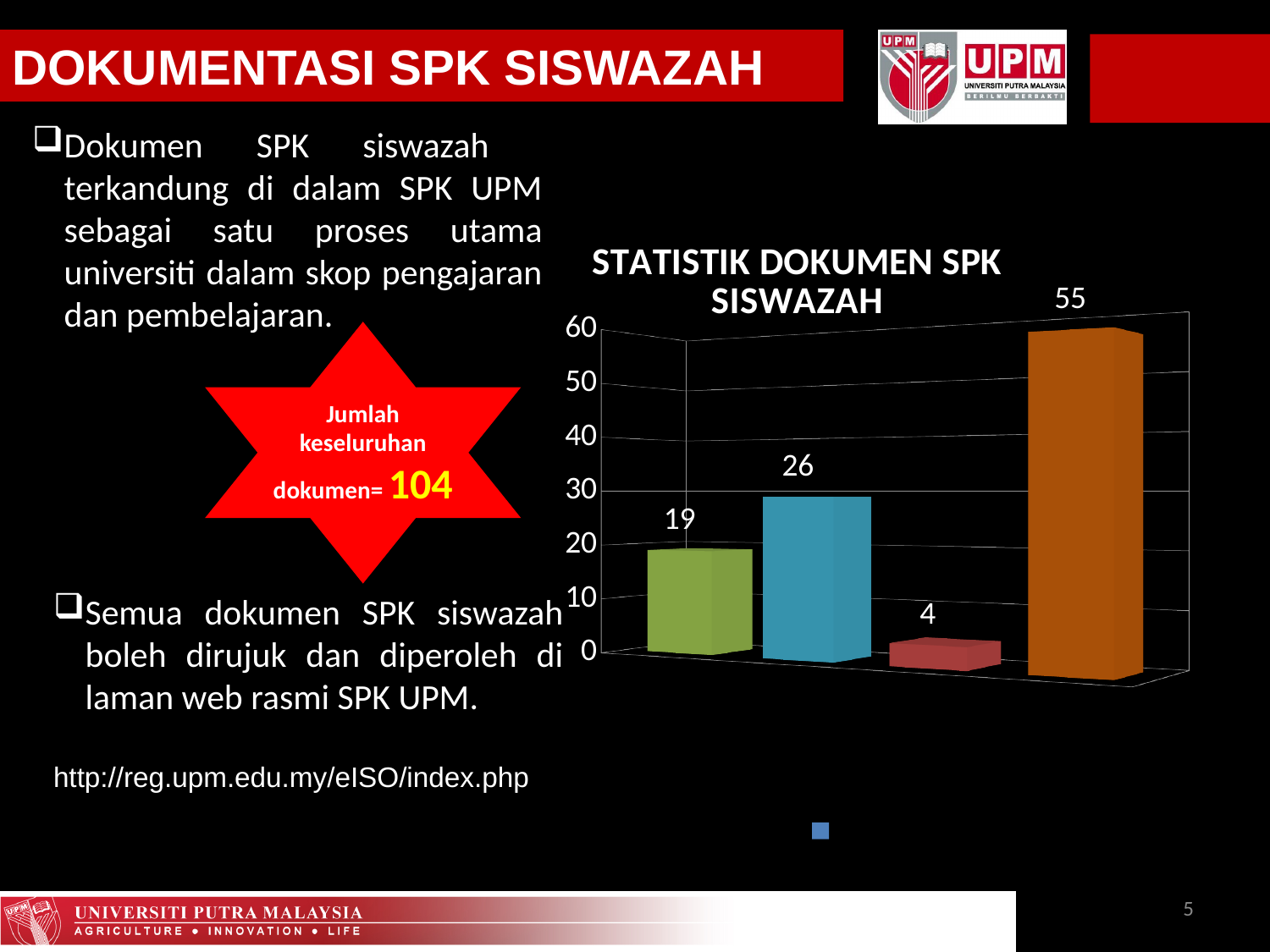
What kind of chart is shown on the slide? bar chart What is the difference between the orange bar (55) and the blue bar (26)? 29 What is the value of the first (green) bar from the left? 19 Which is larger, the green bar or the blue bar? the blue bar What is the value of the third (red) bar from the left? 4 What is the sum of all four bar values in the chart? 104 How many bars are plotted in the chart? 4 What is the highest value shown in the chart? 55 What is the title of the chart? STATISTIK DOKUMEN SPK SISWAZAH What is the value of the second (blue) bar from the left? 26 What is the lowest value shown in the chart? 4 What is the value of the fourth (orange) bar from the left? 55